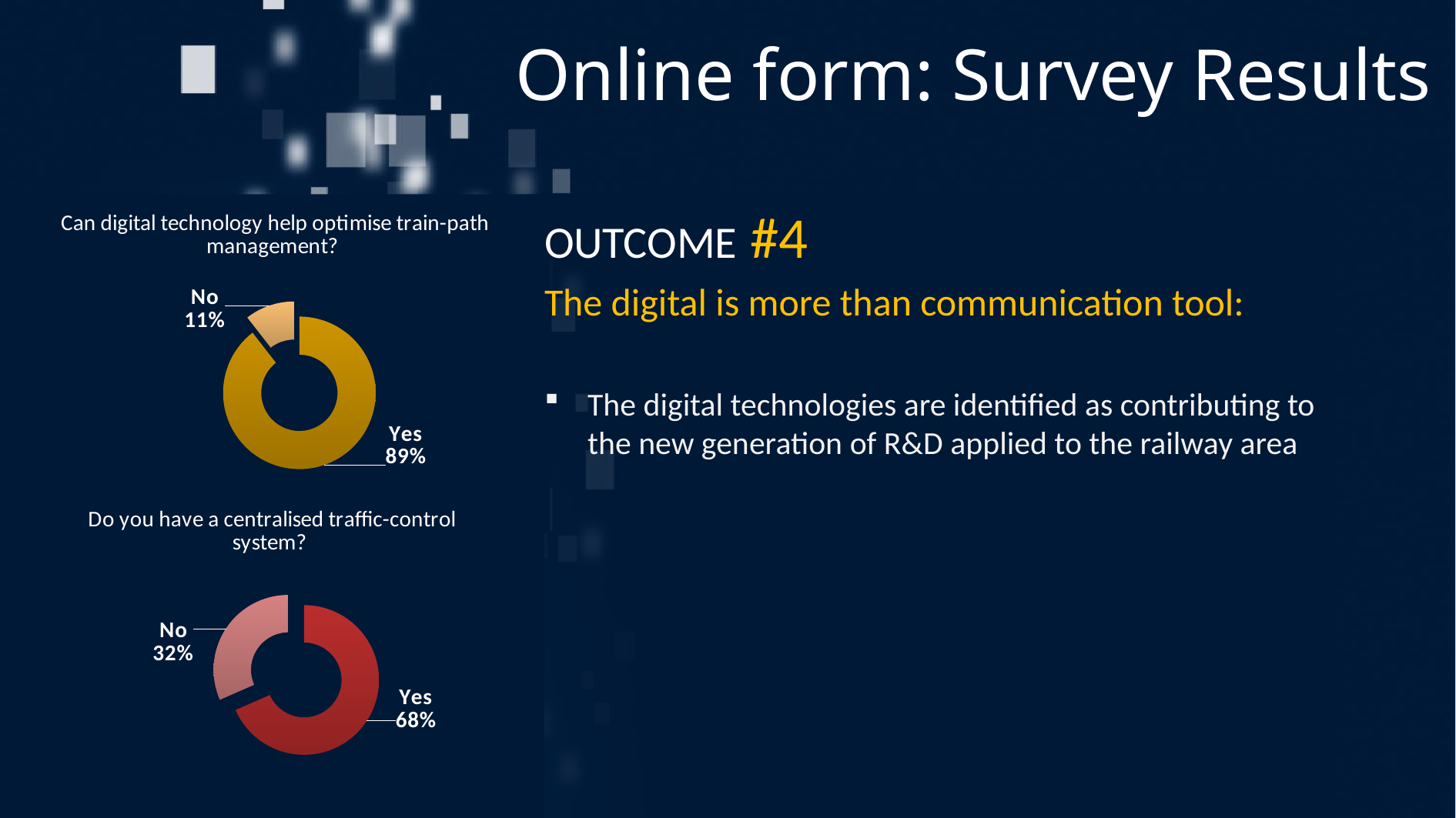
How many charts are shown on the slide? 2 In the chart titled "Do you have a centralised traffic-control system?", what percentage answered No? 32% What kind of chart is used for "Do you have a centralised traffic-control system?"? Doughnut (pie) chart In the chart titled "Can digital technology help optimise train-path management?", what is the difference in percentage points between Yes and No? 78 In the chart titled "Do you have a centralised traffic-control system?", which answer has the smallest share? No How many categories are shown in the chart titled "Can digital technology help optimise train-path management?"? 2 In the chart titled "Can digital technology help optimise train-path management?", which answer has the largest share? Yes In the chart titled "Do you have a centralised traffic-control system?", what percentage answered Yes? 68% In the chart titled "Can digital technology help optimise train-path management?", what percentage answered No? 11% In the chart titled "Do you have a centralised traffic-control system?", what is the difference in percentage points between Yes and No? 36 Which is larger: the Yes share in the train-path management chart or the Yes share in the centralised traffic-control chart? The Yes share in the train-path management chart In the chart titled "Can digital technology help optimise train-path management?", what percentage answered Yes? 89%